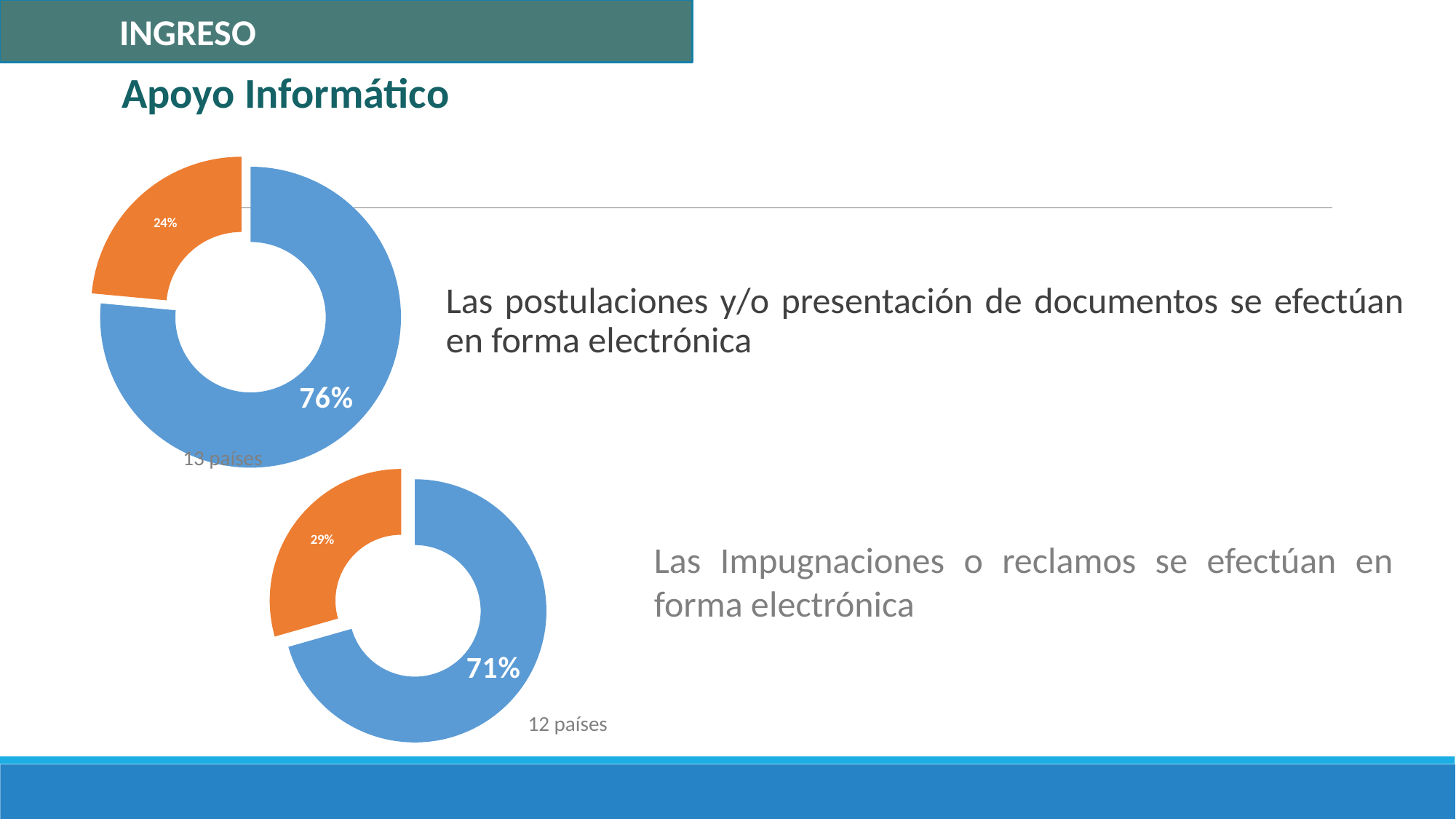
How many segments does the top chart have? 2 How many countries does the label next to the bottom chart say it covers? 12 países In the top chart, what percentage does the blue segment show? 76% What type of chart is the top chart on the slide? doughnut chart In the bottom chart, what percentage does the orange segment show? 29% In the top chart, what percentage does the orange segment show? 24% In the bottom chart, what percentage does the blue segment show? 71% How many segments does the bottom chart have? 2 What is the difference between the blue and orange segments in the top chart? 52% In the bottom chart, which segment is the smallest? the orange segment (29%) In the top chart, which segment is larger, the blue one or the orange one? blue What is the difference between the blue segment of the top chart (76%) and the blue segment of the bottom chart (71%)? 5%